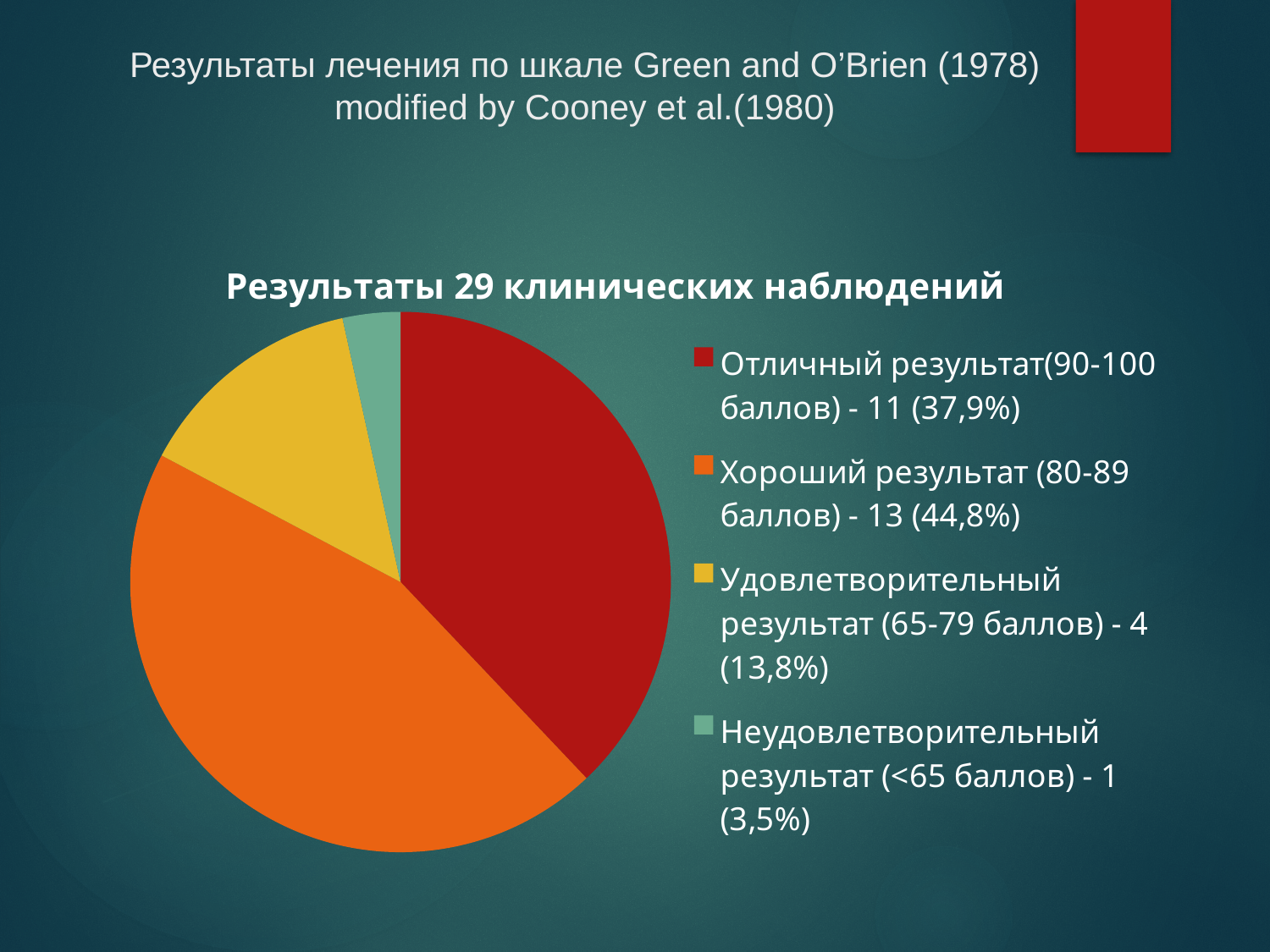
Which category has the smallest slice of the pie? Неудовлетворительный результат (<65 баллов) Which is larger: the number of excellent results (Отличный результат) or satisfactory results (Удовлетворительный результат)? Отличный результат How many observations had a satisfactory result (Удовлетворительный результат, 65-79 баллов)? 4 What share of the pie does the unsatisfactory result (Неудовлетворительный результат, <65 баллов) represent? 3,5% What is the title of the chart? Результаты 29 клинических наблюдений How many slices does the pie chart have? 4 What kind of chart is shown on the slide? pie chart How many observations had a good result (Хороший результат, 80-89 баллов)? 13 What share of the pie does the good result (Хороший результат) represent? 44,8% What is the difference between the number of good results (Хороший результат) and excellent results (Отличный результат)? 2 Which category has the largest slice of the pie? Хороший результат (80-89 баллов) How many observations had an excellent result (Отличный результат, 90-100 баллов)? 11